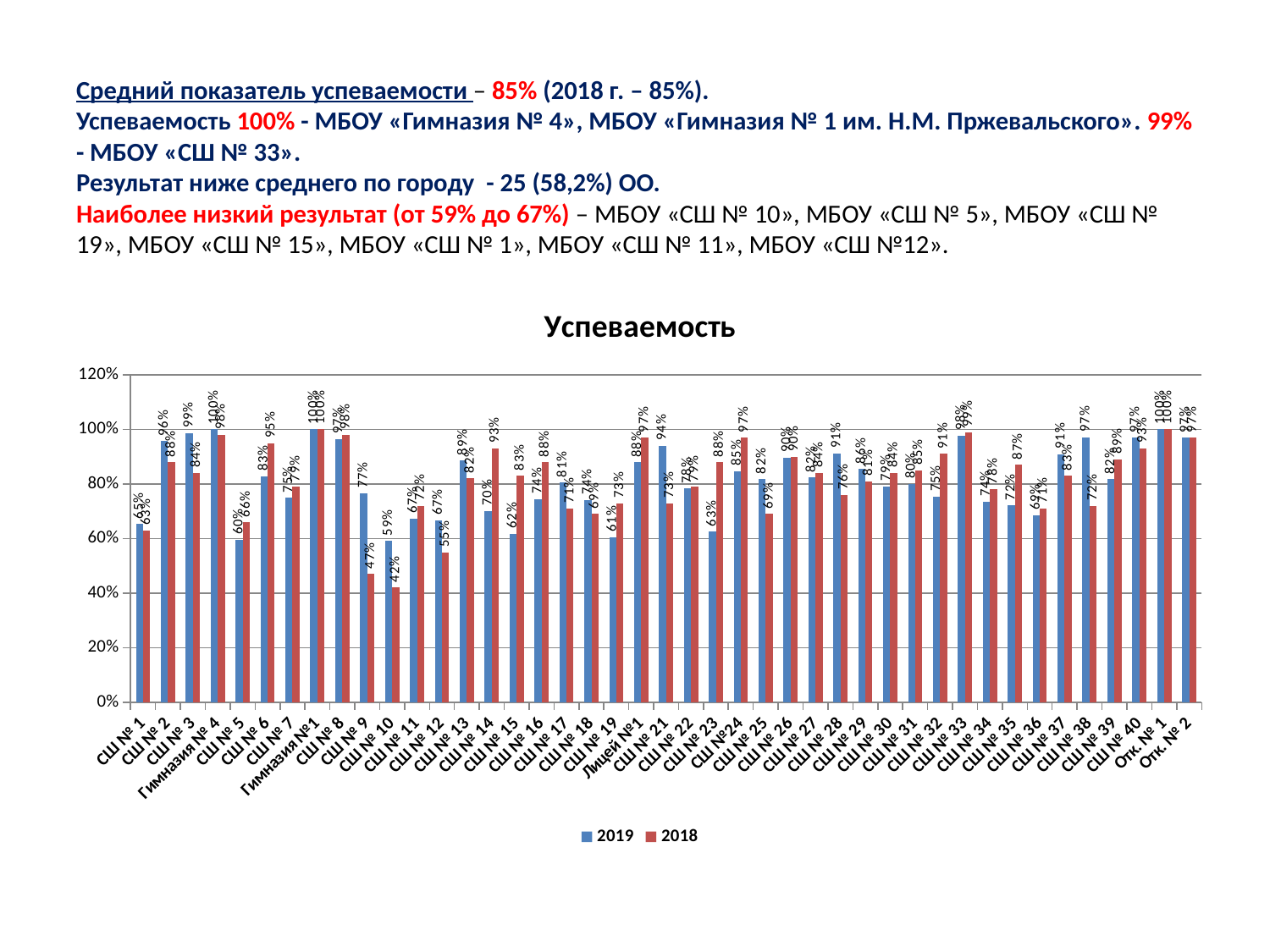
What is the difference between the 2019 and 2018 values for СШ № 38? 25% What is the 2019 value for СШ № 10? 59% How many series does the legend of the chart list? 2 Which category has the lowest 2018 value? СШ № 10 Is the 2018 value for СШ № 12 greater or less than 60%? less What is the 2018 value for СШ № 9? 47% What type of chart is shown on the slide? bar chart Which category has the lowest 2019 value? СШ № 10 What is the title of the chart? Успеваемость Which is larger for СШ № 23, the 2019 value or the 2018 value? 2018 What is the 2019 value for СШ № 21? 94% Which is larger for СШ № 14, the 2019 value or the 2018 value? 2018